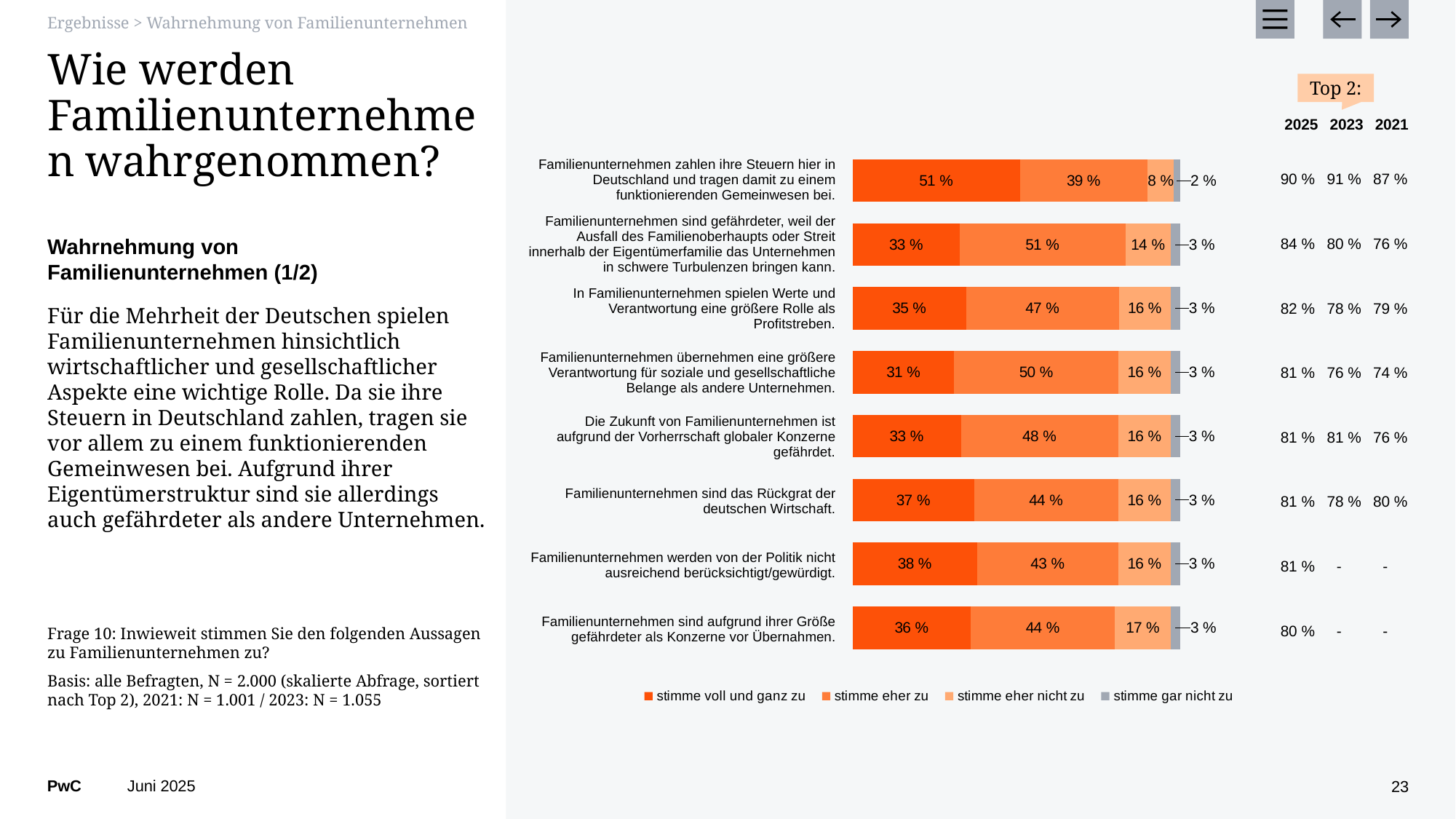
What is the "stimme eher nicht zu" value for the statement "Familienunternehmen sind aufgrund ihrer Größe gefährdeter als Konzerne vor Übernahmen"? 17 % For the statement about Familienunternehmen paying their taxes in Germany, how many percentage points higher is "stimme voll und ganz zu" than "stimme eher zu"? 12 percentage points Which statement has the lowest "stimme voll und ganz zu" share? Familienunternehmen übernehmen eine größere Verantwortung für soziale und gesellschaftliche Belange als andere Unternehmen. Which statement has the highest "stimme voll und ganz zu" share? Familienunternehmen zahlen ihre Steuern hier in Deutschland und tragen damit zu einem funktionierenden Gemeinwesen bei. What is the "stimme eher zu" value for the statement "Familienunternehmen sind das Rückgrat der deutschen Wirtschaft"? 44 % What type of chart is shown on the slide? Stacked bar chart How many response categories does the legend list? 4 What percentage of respondents answered "stimme voll und ganz zu" to the statement "Familienunternehmen zahlen ihre Steuern hier in Deutschland und tragen damit zu einem funktionierenden Gemeinwesen bei"? 51 % Which statement has the larger "stimme eher zu" share: the one about paying taxes in Germany or the one about being the Rückgrat der deutschen Wirtschaft? Familienunternehmen sind das Rückgrat der deutschen Wirtschaft. How many statements are shown as bars in the chart? 8 What is the combined share of "stimme voll und ganz zu" and "stimme eher zu" for the statement "Familienunternehmen sind das Rückgrat der deutschen Wirtschaft"? 81 % What is the "stimme gar nicht zu" value for the statement about Familienunternehmen paying their taxes in Germany? 2 %